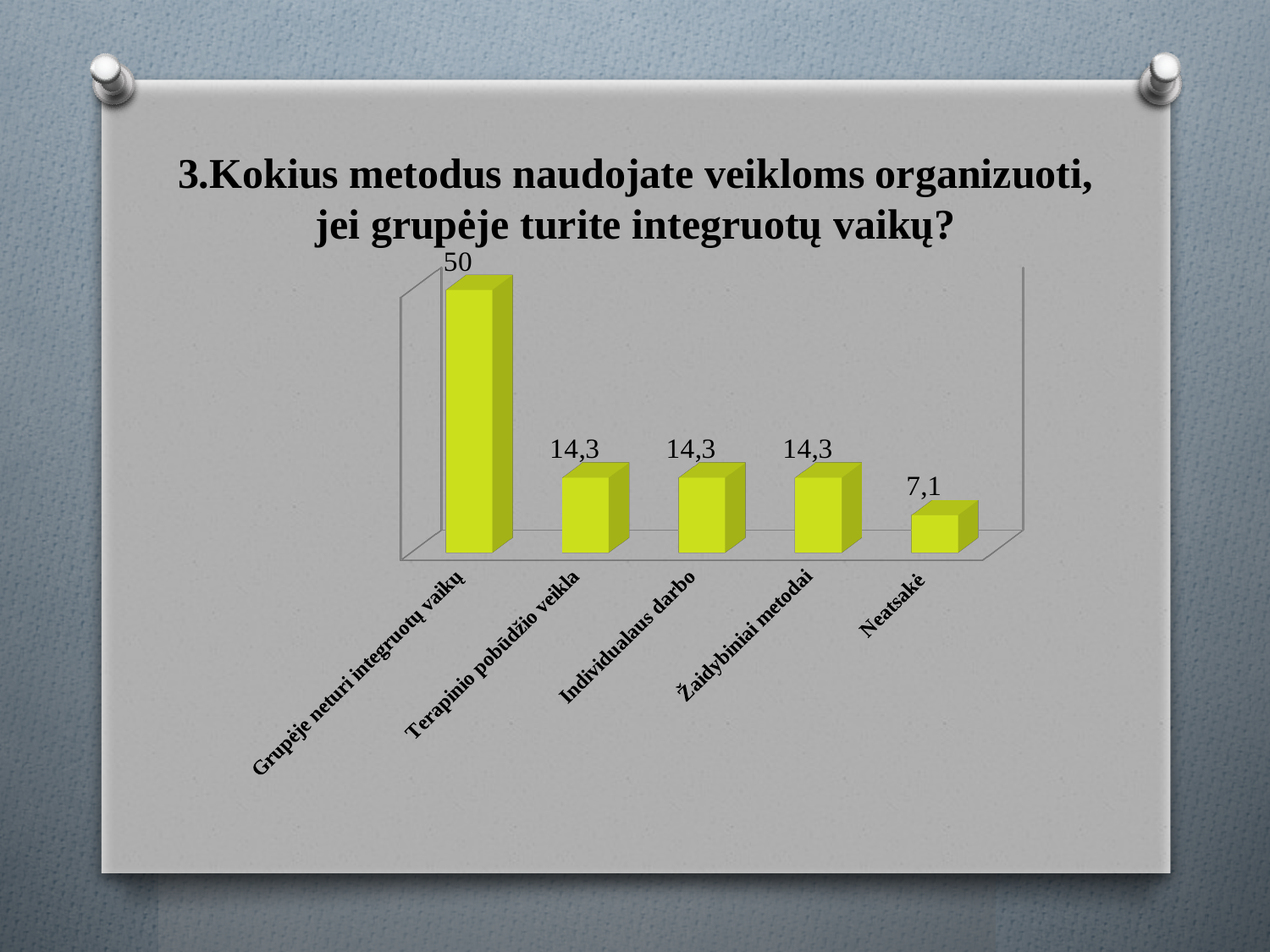
What kind of chart is shown on the slide? Bar chart What colour are the bars in the chart? Yellow-green How many categories are shown in the chart? 5 What is the value for "Individualaus darbo"? 14,3 Which category has the highest value? Grupėje neturi integruotų vaikų What is the difference between the values for "Žaidybiniai metodai" and "Neatsakė"? 7,2 How many categories share the value 14,3? 3 What is the value for "Grupėje neturi integruotų vaikų"? 50 What is the difference between the values for "Grupėje neturi integruotų vaikų" and "Terapinio pobūdžio veikla"? 35,7 What is the value for "Neatsakė"? 7,1 Which is larger, the value for "Terapinio pobūdžio veikla" or the value for "Neatsakė"? Terapinio pobūdžio veikla Which category has the lowest value? Neatsakė